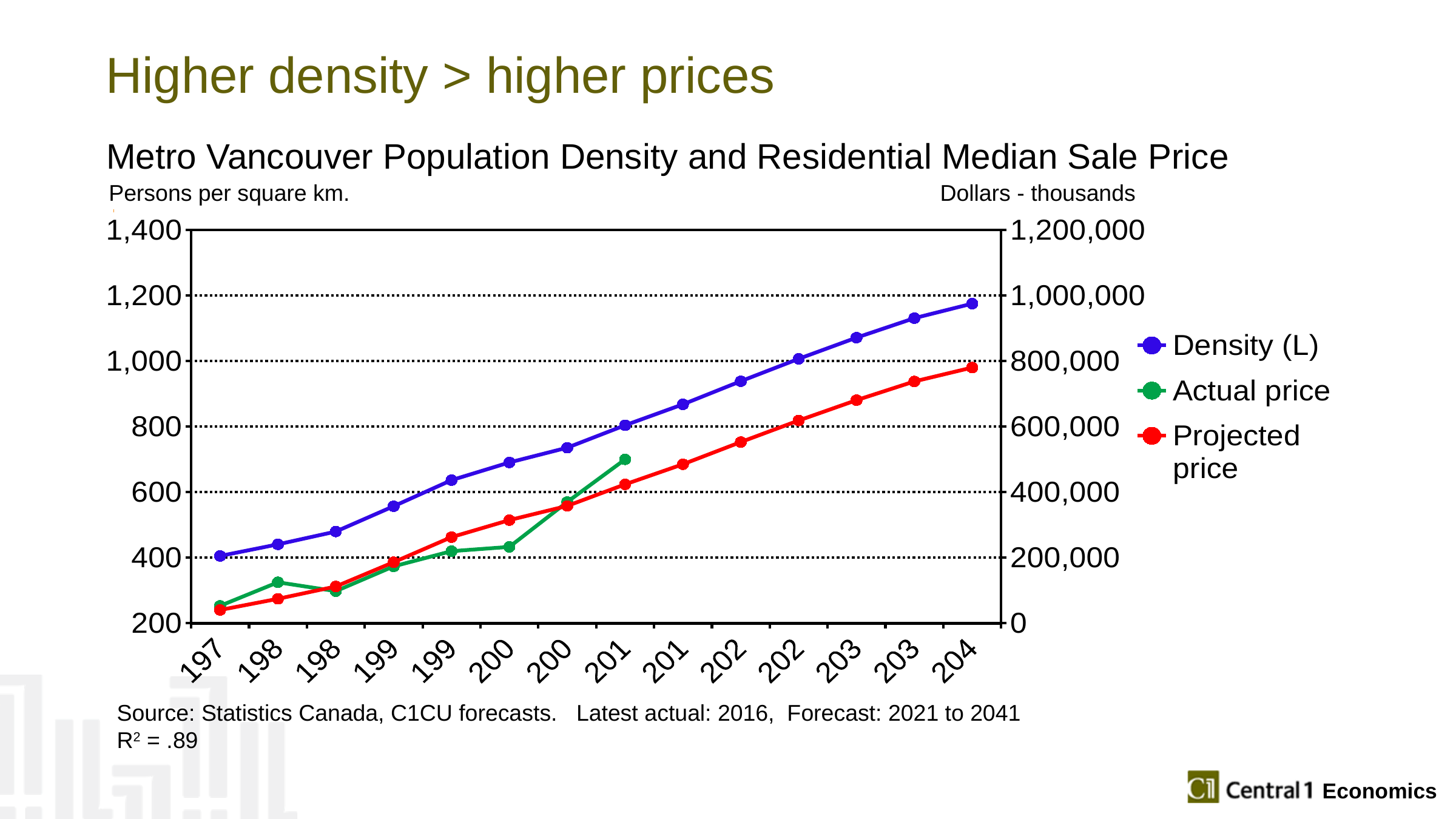
Is the value for Actual price at its last plotted point greater or less than 400,000? greater What kind of chart is shown on the slide? line chart What is the label of the left vertical axis? Persons per square km. Is the value for Density (L) at the last point on the x axis greater or less than 1,200? less Is the value for Projected price at the last point on the x axis greater or less than 800,000? less What is the title of the chart? Metro Vancouver Population Density and Residential Median Sale Price Does the Density (L) series rise or fall from left to right along the x axis? rise How many points are plotted along the x axis for the Density (L) series? 14 How many points are plotted for the Actual price series? 8 At which point on the x axis is the Density (L) series highest, the first or the last? the last How many series does the legend list? 3